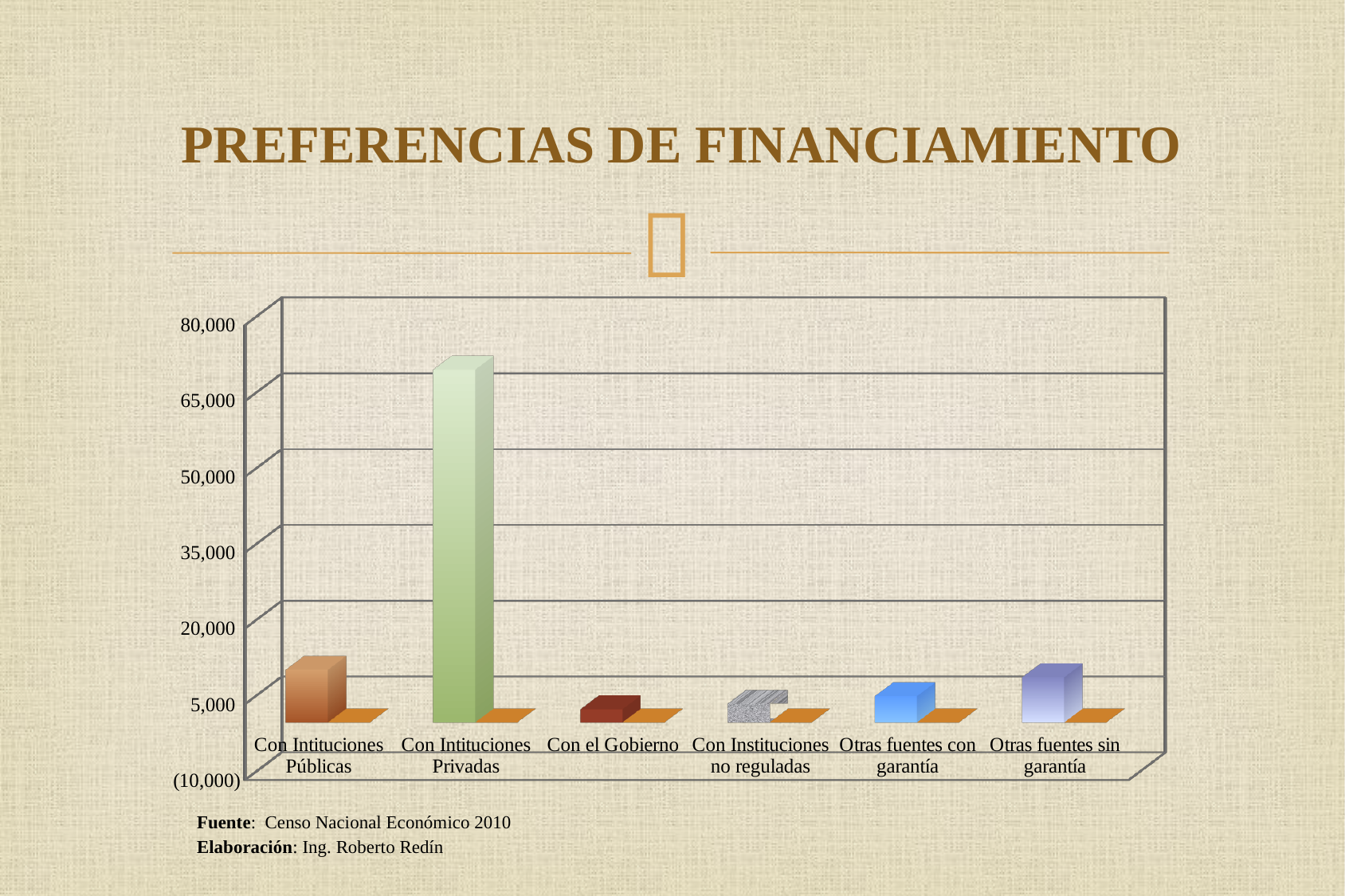
What kind of chart is shown on the slide? bar chart What source is cited below the chart? Censo Nacional Económico 2010 Which is larger, the value for Con Intituciones Públicas or the value for Con el Gobierno? Con Intituciones Públicas Is the value for Con Intituciones Públicas greater or less than 20,000? less Which is larger, the value for Otras fuentes sin garantía or the value for Con Instituciones no reguladas? Otras fuentes sin garantía What is the title of the slide containing the chart? PREFERENCIAS DE FINANCIAMIENTO Is the value for Con Intituciones Privadas greater or less than 80,000? less Which is larger, the value for Con Intituciones Privadas or the value for Con Intituciones Públicas? Con Intituciones Privadas Which category has the highest value? Con Intituciones Privadas Is the value for Con el Gobierno greater or less than 20,000? less How many categories are plotted on the chart? 6